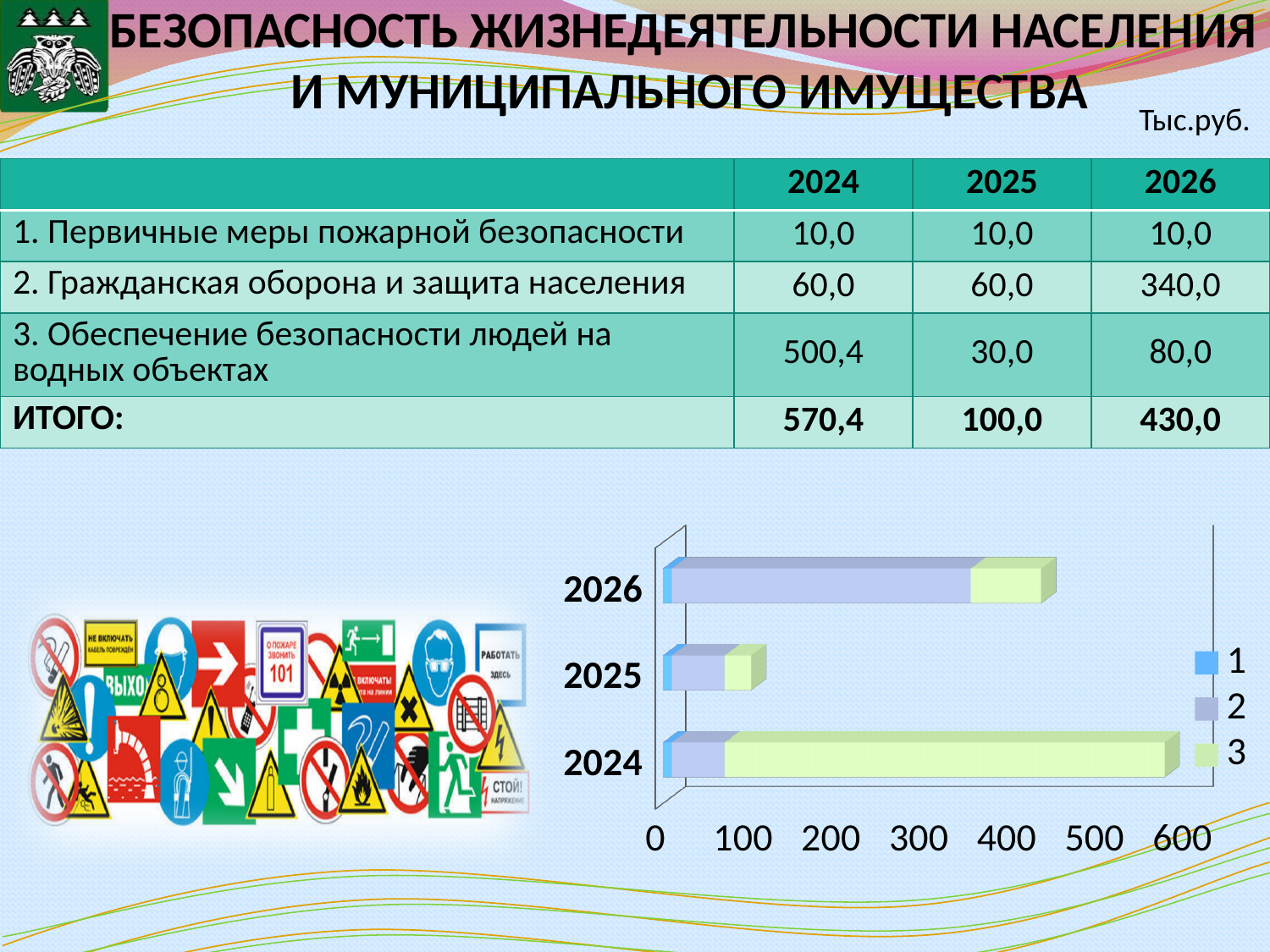
What labels does the chart legend show? 1, 2, 3 Is the total bar for 2026 greater or less than 300? greater How many series does the chart legend list? 3 What is the total of the stacked bar for 2024 (ИТОГО)? 570,4 What is the difference between the totals for 2024 and 2025? 470,4 Is the total bar for 2025 greater or less than 200? less Is the total bar for 2024 greater or less than 500? greater Which year has the shortest total bar in the chart? 2025 How many categories (years) does the bar chart show? 3 Which year has the longest total bar in the chart? 2024 What kind of chart is shown on the slide? bar chart Which total bar is longer, 2026 or 2025? 2026